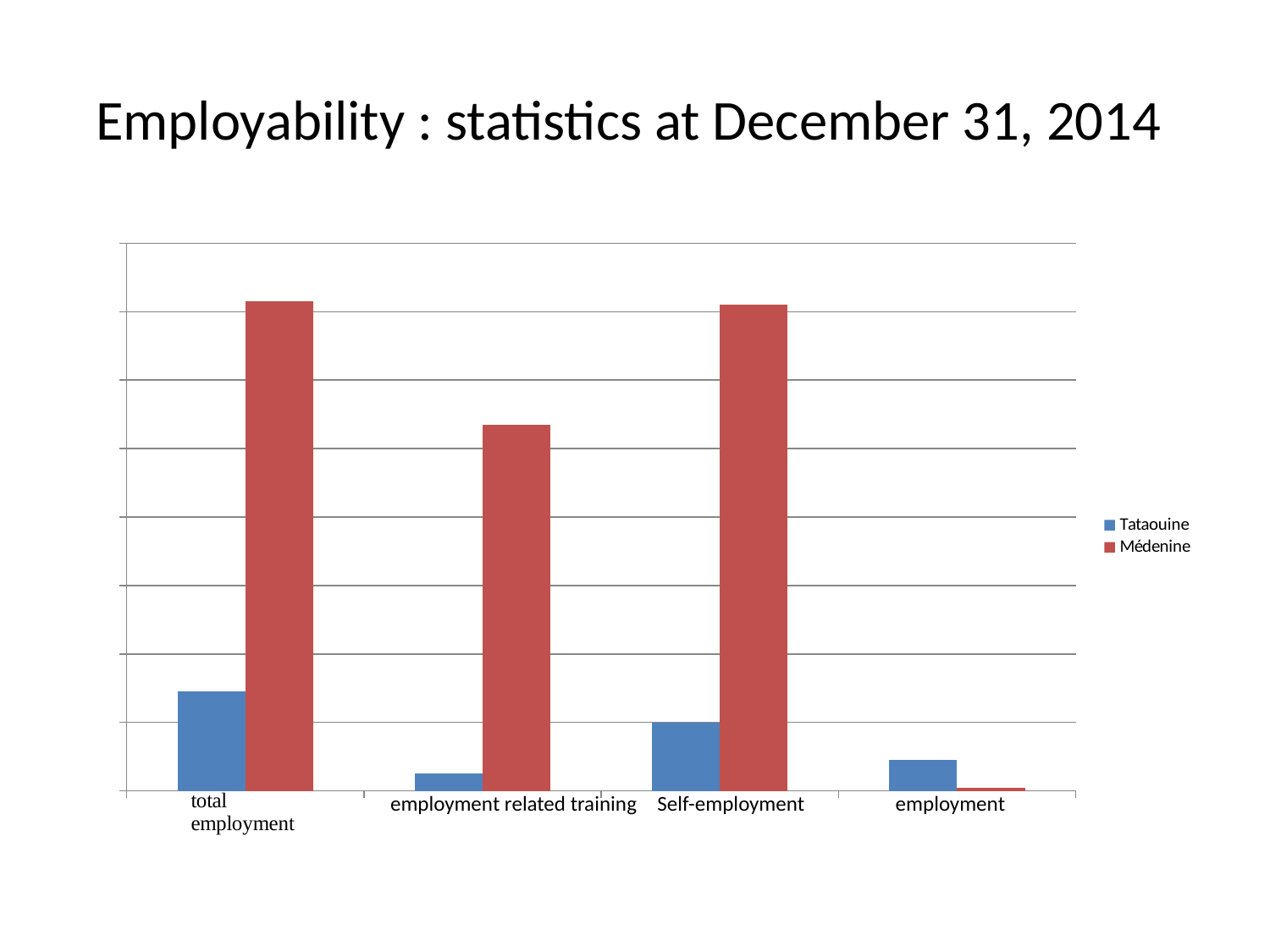
What kind of chart is shown on the slide? bar chart For the Tataouine series, which is larger: Self-employment or employment? Self-employment Which series is shown in red in the legend? Médenine How many series does the legend list? 2 For which category is the Tataouine value highest? total employment For total employment, which series has the larger value, Tataouine or Médenine? Médenine How many categories are shown on the x axis? 4 For which category is the Médenine value lowest? employment What is the title of the slide containing the chart? Employability : statistics at December 31, 2014 For the Médenine series, which is larger: employment related training or Self-employment? Self-employment Does the Médenine value rise or fall from Self-employment to employment? fall For which category is the Tataouine value lowest? employment related training